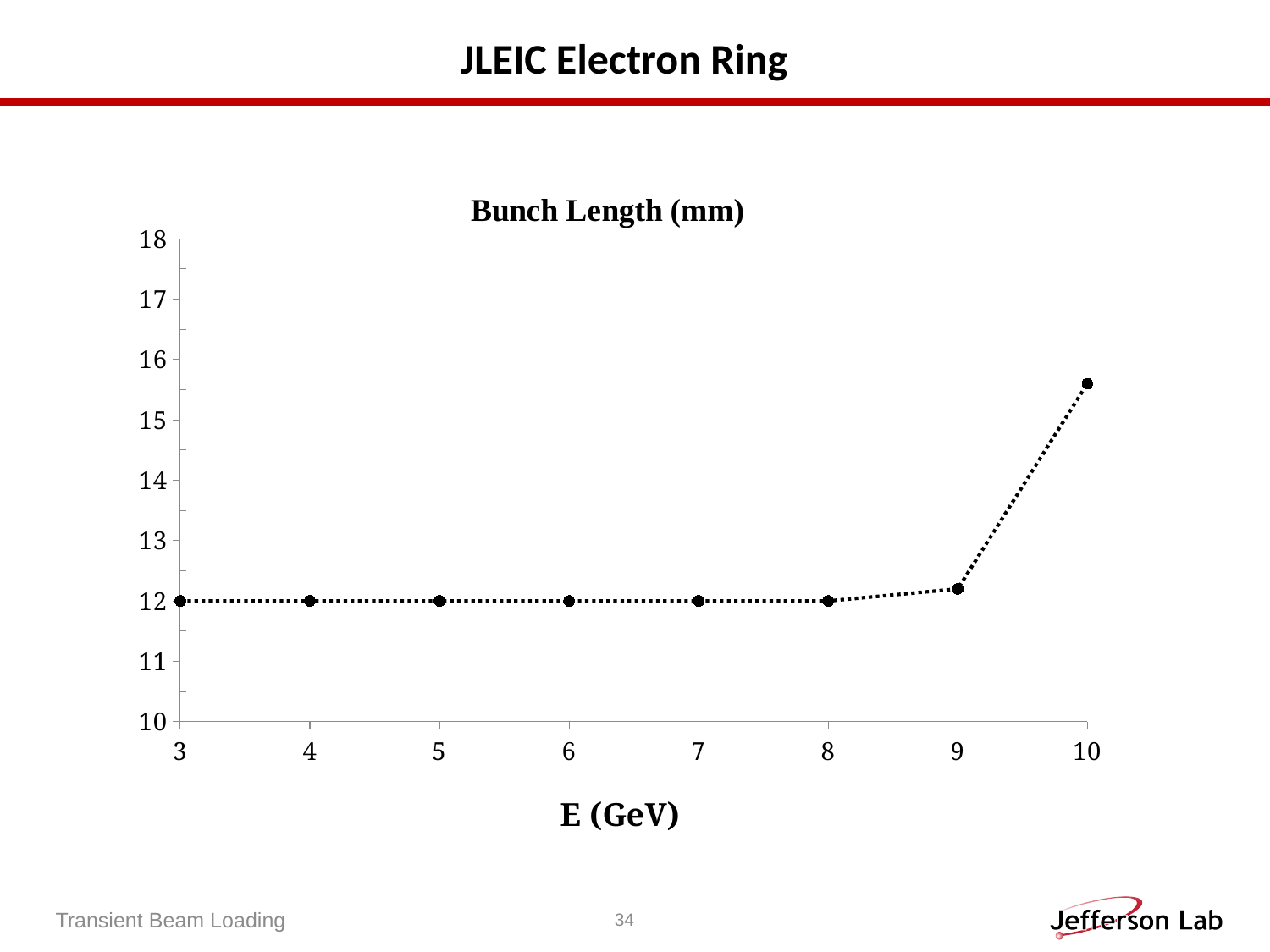
At which energy is the bunch length highest? 10 GeV Which has the larger bunch length, E = 9 GeV or E = 10 GeV? 10 GeV What is the label of the x axis? E (GeV) What is the bunch length at E = 8 GeV? 12 How many data points are plotted on the chart? 8 What is the bunch length at E = 6 GeV? 12 Is the bunch length at E = 10 GeV greater or less than 16? less What is the bunch length at E = 3 GeV? 12 What is the title of the chart? Bunch Length (mm) Is the bunch length at E = 9 GeV greater or less than 13? less Is the bunch length at E = 10 GeV greater or less than 15? greater What kind of chart is shown on the slide? line chart